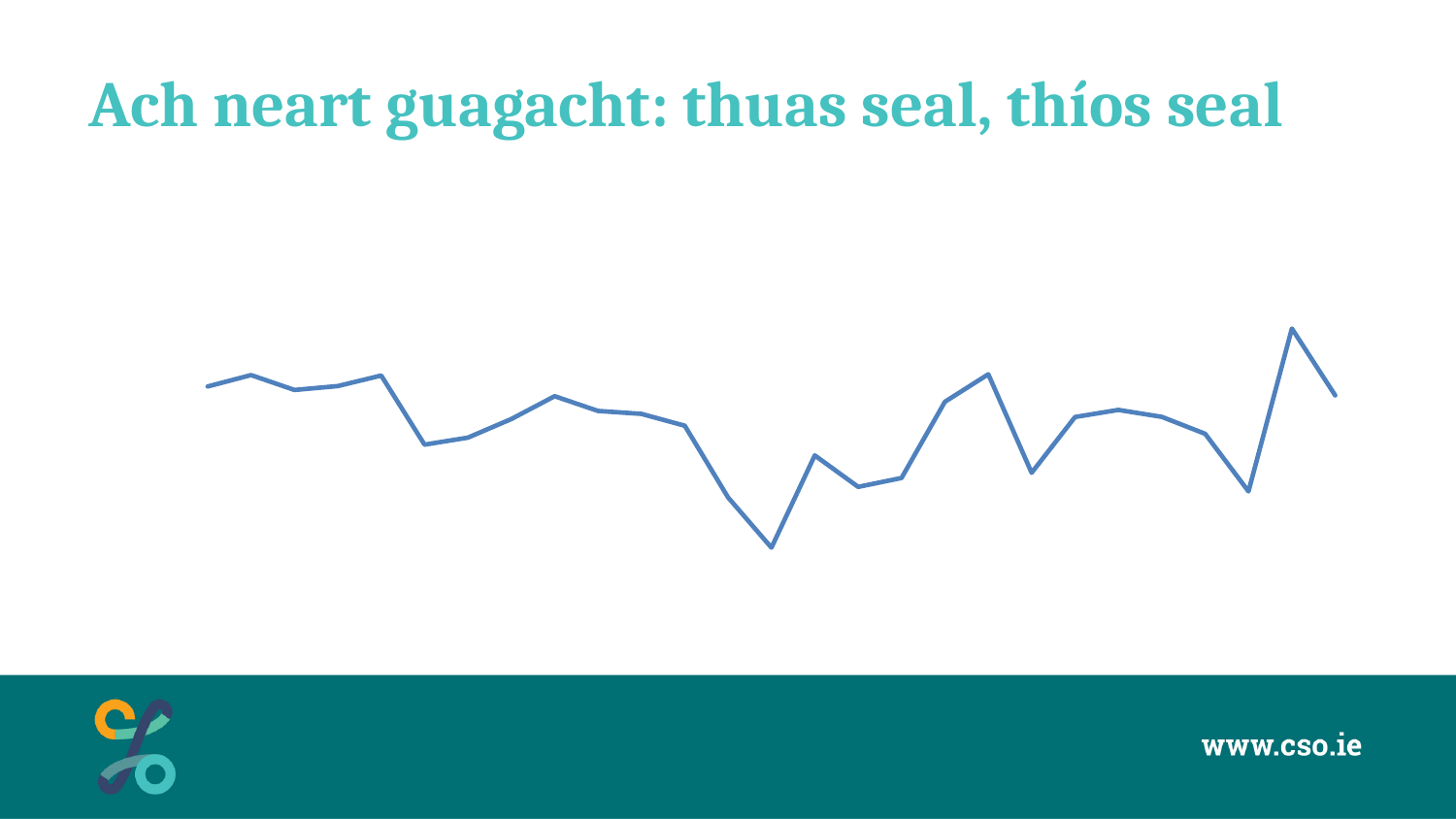
Is the last point of the line higher or lower than the highest peak just before it? Lower What kind of chart is shown on the slide? Line chart What colour is the line plotted on the chart? Blue Where along the line does the chart reach its highest point: near the left, in the middle, or near the right? Near the right How many data points does the line on the chart have? 27 What is the title of the slide containing the chart? Ach neart guagacht: thuas seal, thíos seal How many data series are plotted on the chart? 1 Where along the line does the chart reach its lowest point: near the left, in the middle, or near the right? In the middle Does the line rise or fall between its lowest point and the point immediately after it? Rise